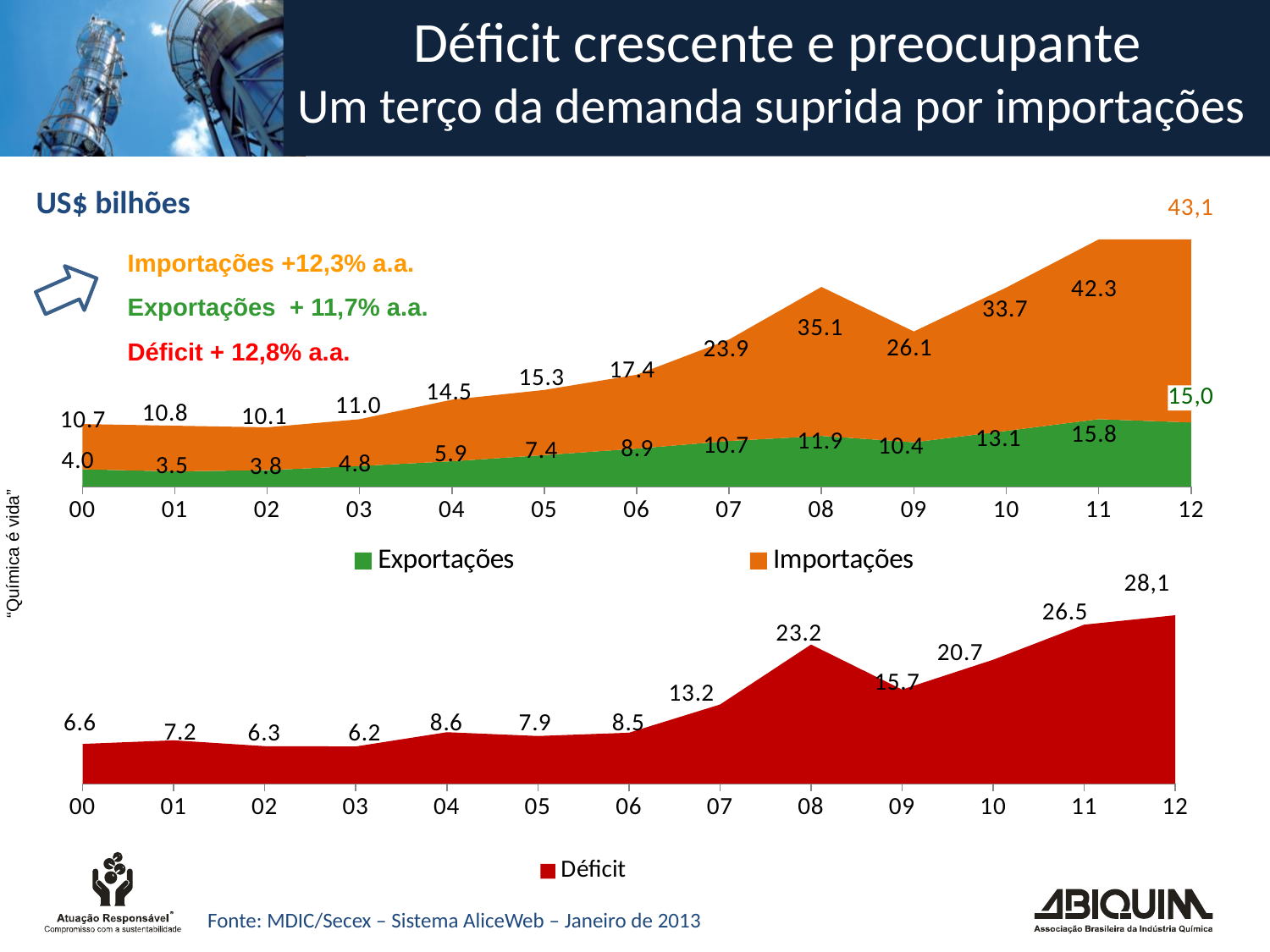
In the top chart (Exportações / Importações), what is the difference between Importações and Exportações in 08? 23.2 In the top chart (Exportações / Importações), which year has the lowest Exportações value? 01 In the bottom chart (Déficit), which year has the lowest value? 03 What kind of chart is the bottom chart (Déficit)? Area chart In the bottom chart (Déficit), what is the difference between the values for 11 and 10? 5.8 In the top chart (Exportações / Importações), which year has the highest Importações value? 12 In the top chart (Exportações / Importações), which is larger: Importações in 09 or Importações in 10? Importações in 10 In the bottom chart (Déficit), what is the value for 08? 23.2 In the top chart (Exportações / Importações), what is the value of Importações for 08? 35.1 How many series does the legend of the top chart list? 2 In the top chart (Exportações / Importações), what is the value of Exportações for 11? 15.8 How many years are shown on the x axis of the bottom chart (Déficit)? 13